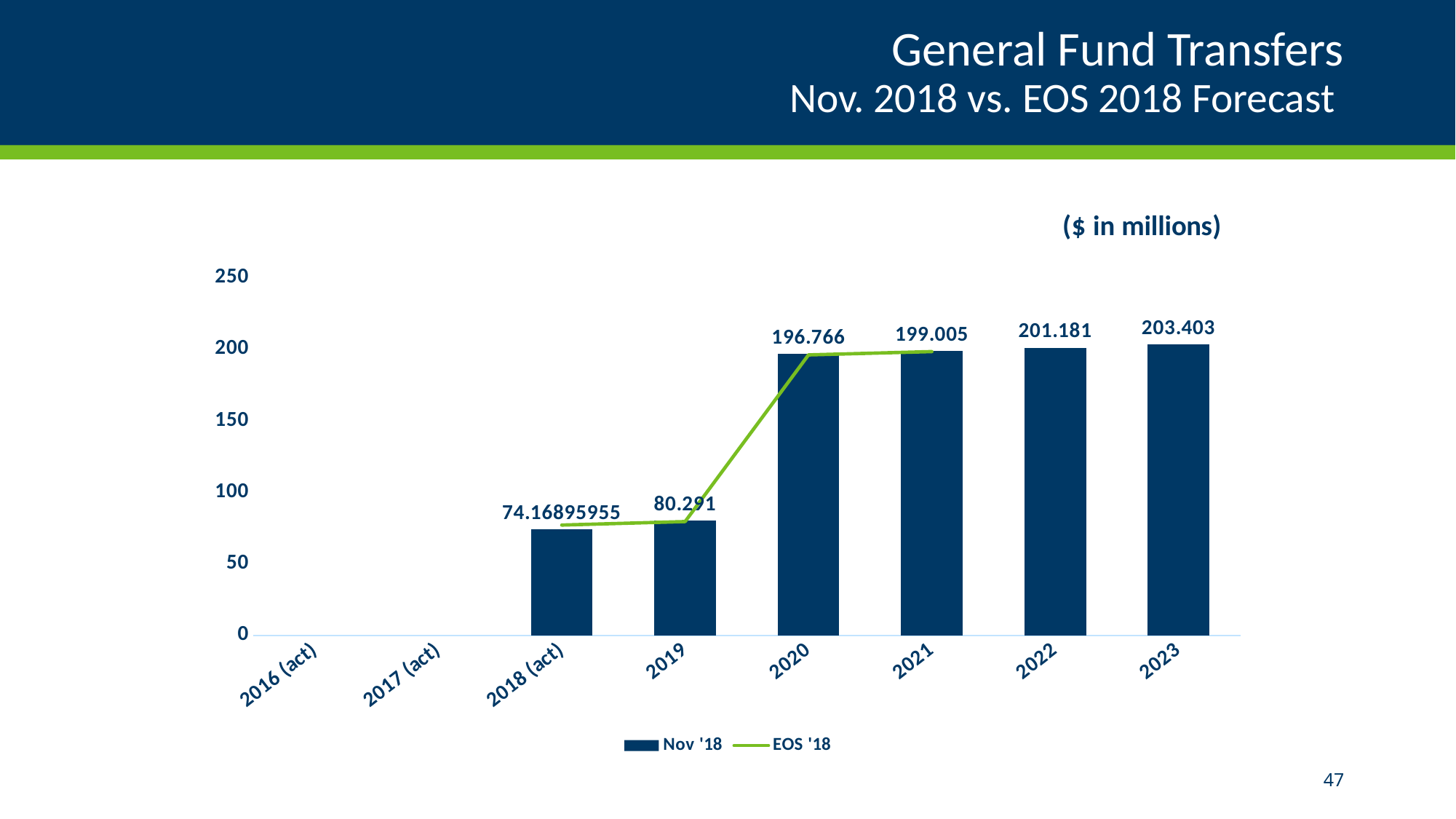
What is the Nov '18 value for 2018 (act)? 74.16895955 Which is larger, the Nov '18 value for 2020 or for 2019? 2020 How many series does the legend list? 2 What is the difference between the Nov '18 values for 2020 and 2019? 116.475 What is the Nov '18 value for 2019? 80.291 How many categories are shown on the x axis? 8 What is the Nov '18 value for 2023? 203.403 What is the difference between the Nov '18 values for 2023 and 2022? 2.222 Among the years with a Nov '18 bar, which has the lowest value? 2018 (act) Which year has the highest Nov '18 bar? 2023 Is the EOS '18 value for 2019 greater or less than 100? less What unit is stated for the values in the chart? $ in millions